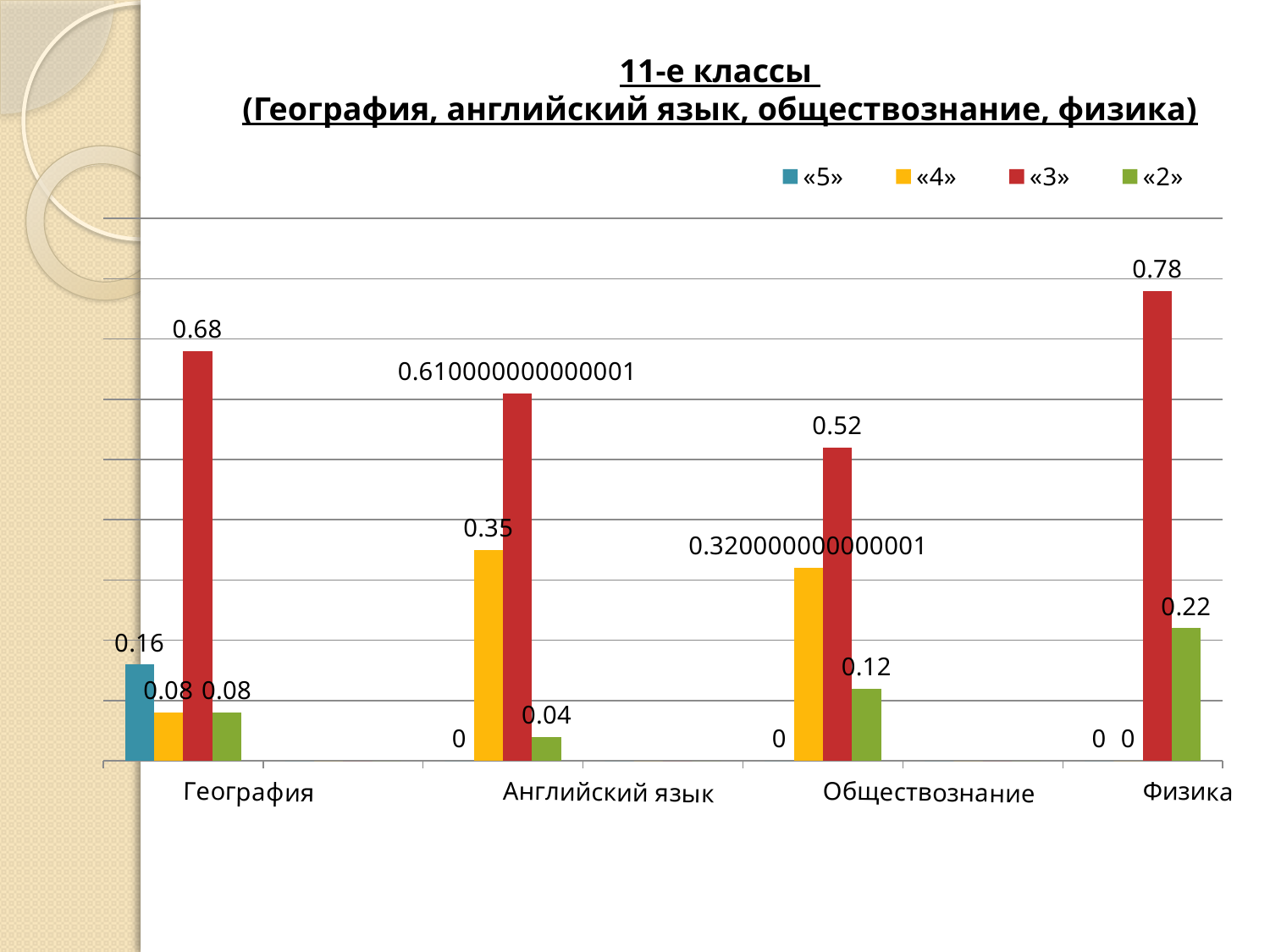
What is the difference between the «3» values for Физика and География? 0.10 What kind of chart is shown on the slide? Bar chart What is the value for «3» in Физика? 0.78 What is the value for «5» in География? 0.16 Which subject has the highest value for «3»? Физика What is the value for «4» in Английский язык? 0.35 What is the value for «2» in Обществознание? 0.12 What is the value for «4» in Физика? 0 How many subjects are shown on the x axis? 4 How many series does the legend list? 4 Which subject has the lowest value for «2»? Английский язык Which is larger: the «4» value for Английский язык or the «2» value for Физика? «4» for Английский язык